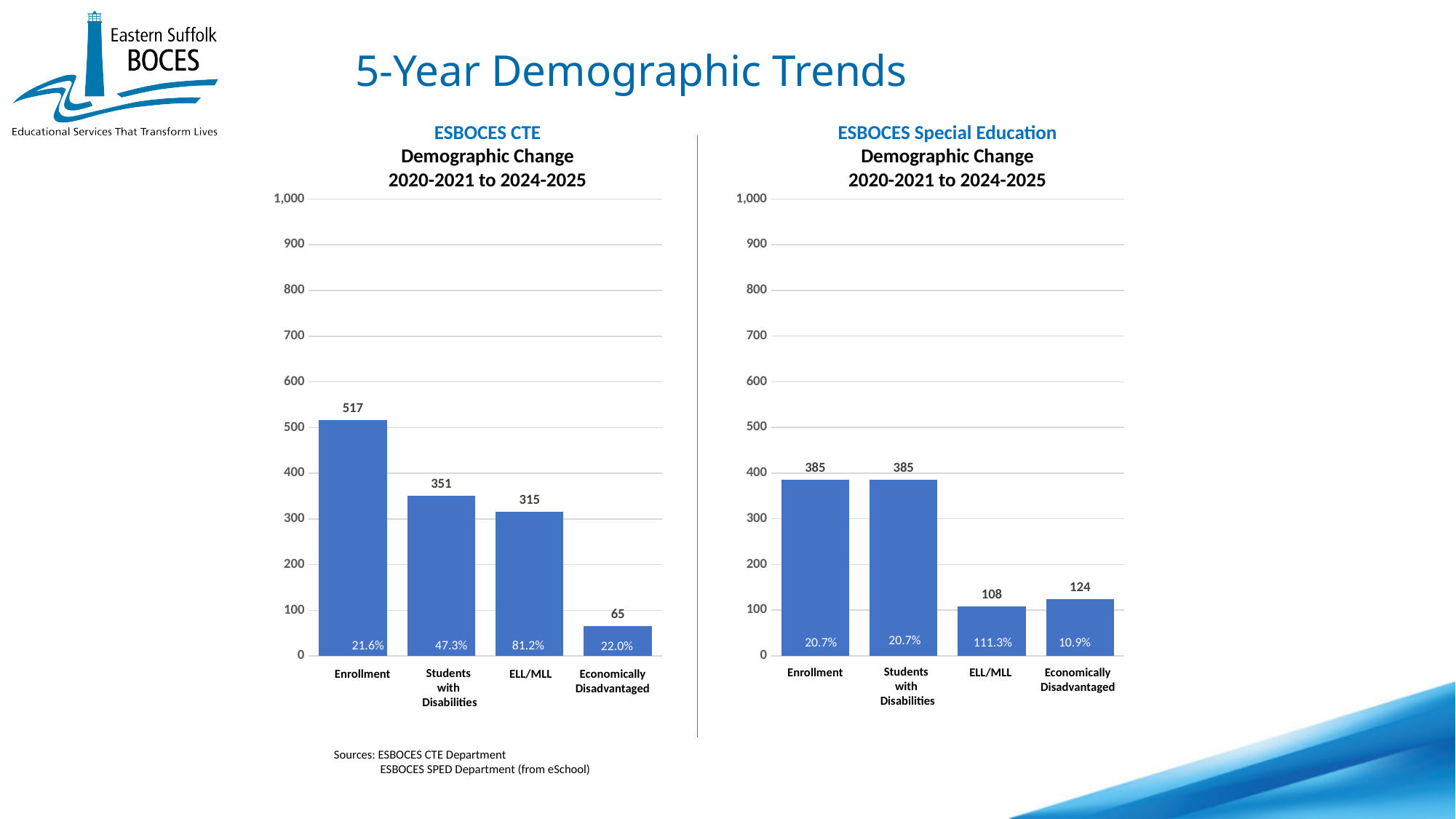
In the ESBOCES Special Education chart, which category has the lowest value? ELL/MLL In the ESBOCES CTE chart, which category has the lowest value? Economically Disadvantaged What period does the ESBOCES CTE chart title say the demographic change covers? 2020-2021 to 2024-2025 In the ESBOCES CTE chart, what is the difference between the Enrollment value and the Students with Disabilities value? 166 In the ESBOCES CTE chart, what percentage label is shown on the ELL/MLL bar? 81.2% In the ESBOCES Special Education chart, what percentage label is shown on the ELL/MLL bar? 111.3% What kind of chart is the ESBOCES Special Education chart? Bar chart In the ESBOCES Special Education chart, what is the difference between the Economically Disadvantaged value and the ELL/MLL value? 16 How many categories are shown in the ESBOCES CTE chart? 4 In the ESBOCES Special Education chart, what is the value for ELL/MLL? 108 In the ESBOCES CTE chart, what is the value for Enrollment? 517 In the ESBOCES Special Education chart, which is larger: the value for ELL/MLL or the value for Economically Disadvantaged? Economically Disadvantaged